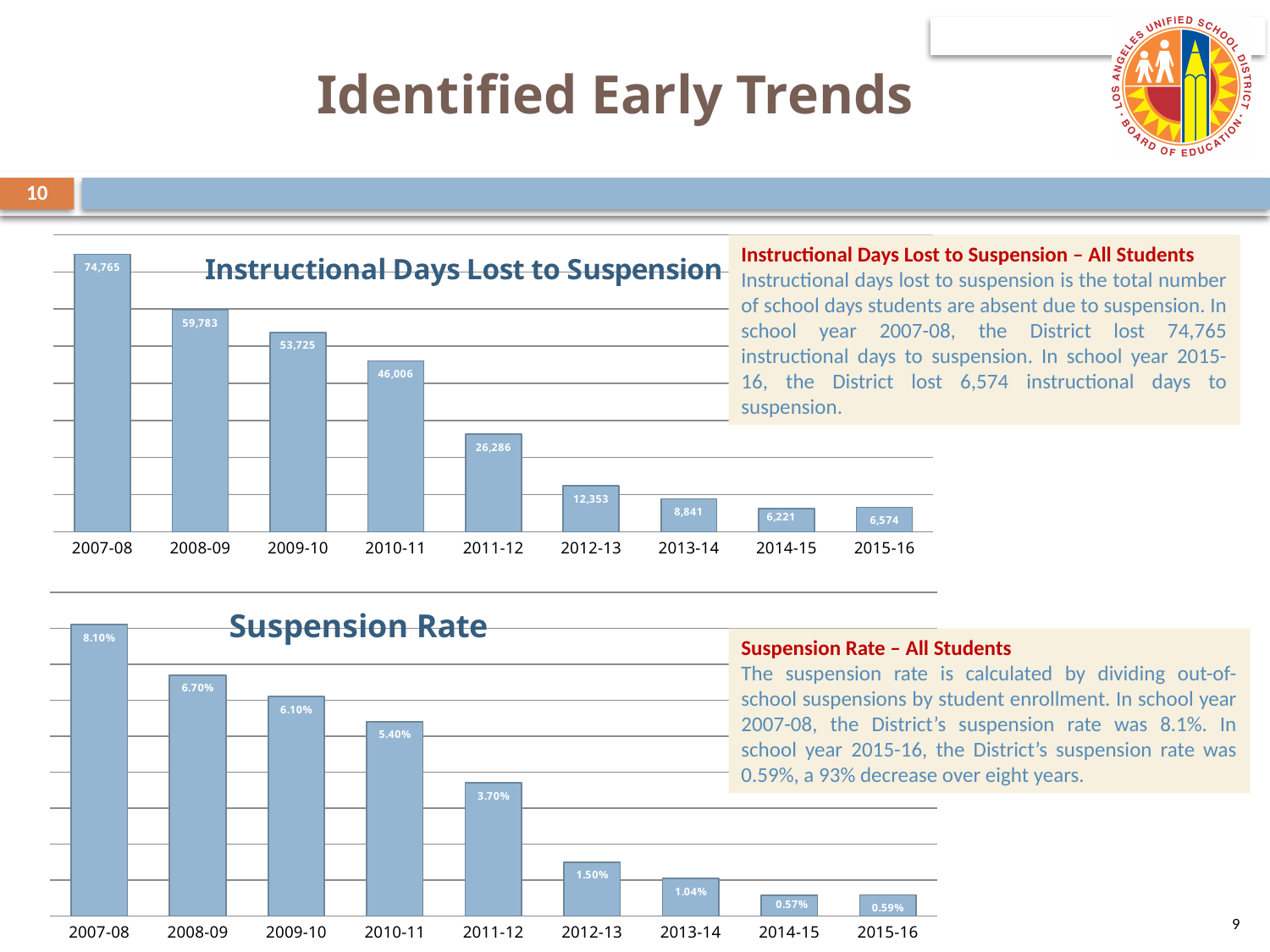
In the 'Suspension Rate' chart, what is the value for 2011-12? 3.70% In the 'Suspension Rate' chart, what is the value for 2015-16? 0.59% In the 'Suspension Rate' chart, what is the difference between the values for 2007-08 and 2012-13? 6.60% In the 'Suspension Rate' chart, which is larger, the value for 2009-10 or the value for 2010-11? 2009-10 In the 'Instructional Days Lost to Suspension' chart, which school year has the highest value? 2007-08 In the 'Instructional Days Lost to Suspension' chart, which school year has the lowest value? 2014-15 In the 'Instructional Days Lost to Suspension' chart, what is the value for 2010-11? 46,006 In the 'Instructional Days Lost to Suspension' chart, how many school years are shown on the x axis? 9 In the 'Instructional Days Lost to Suspension' chart, do the values generally rise or fall from 2007-08 to 2015-16? fall What kind of chart is the 'Suspension Rate' chart? bar chart In the 'Suspension Rate' chart, which school year has the lowest value? 2014-15 In the 'Instructional Days Lost to Suspension' chart, what is the difference between the values for 2007-08 and 2008-09? 14,982